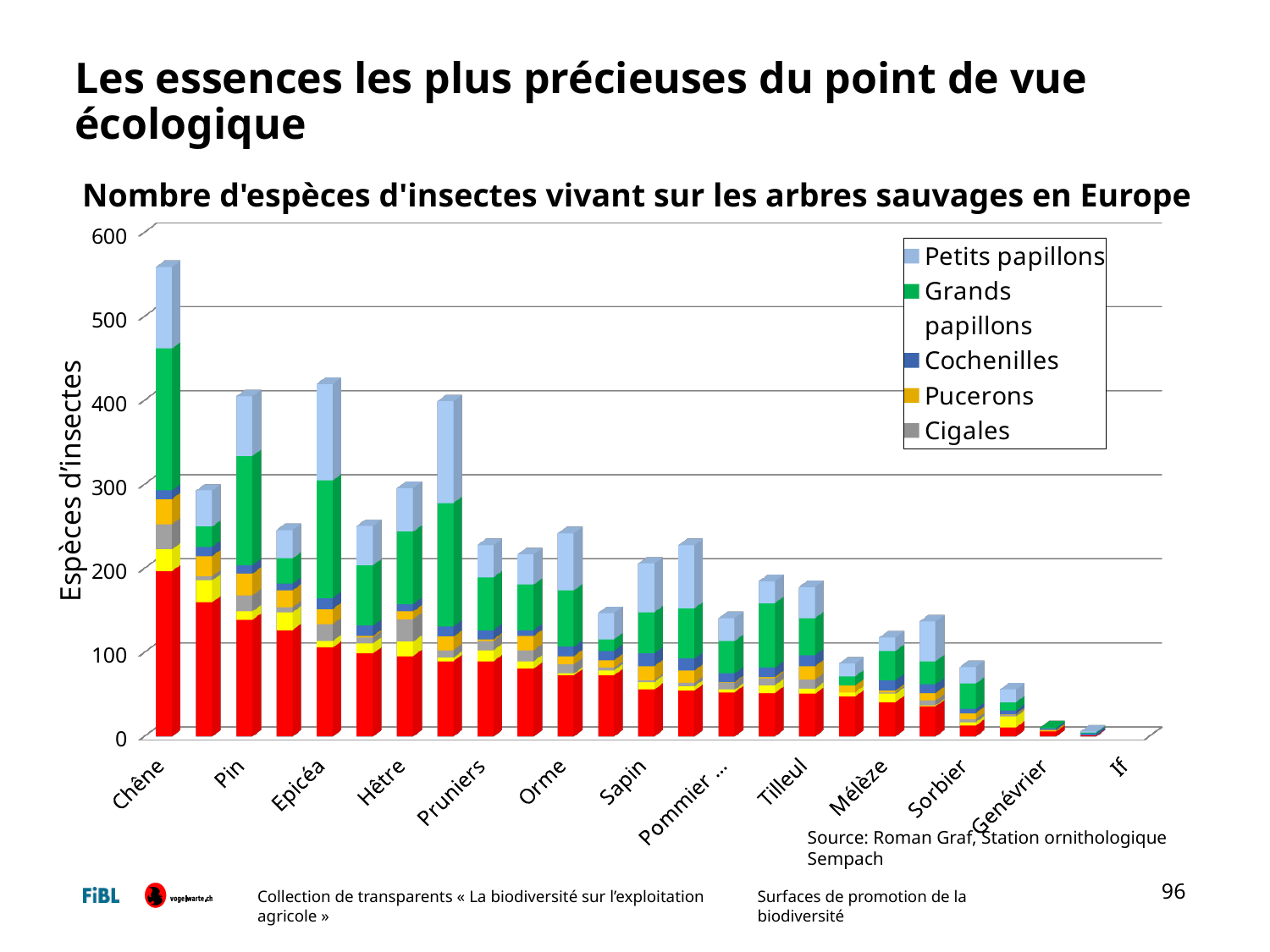
What is the title of the chart? Nombre d'espèces d'insectes vivant sur les arbres sauvages en Europe Which tree species has the highest total number of insect species? Chêne What kind of chart is shown on the slide? Stacked bar chart Which labelled tree species has the lowest total number of insect species? If Is the total value for Epicéa greater or less than 400? greater Do the bar totals generally rise or fall from left to right along the x axis? fall Is the total value for Mélèze greater or less than 100? greater Which has a larger total, Epicéa or Hêtre? Epicéa Is the total value for Genévrier greater or less than 100? less Which has a larger total, Chêne or Pin? Chêne